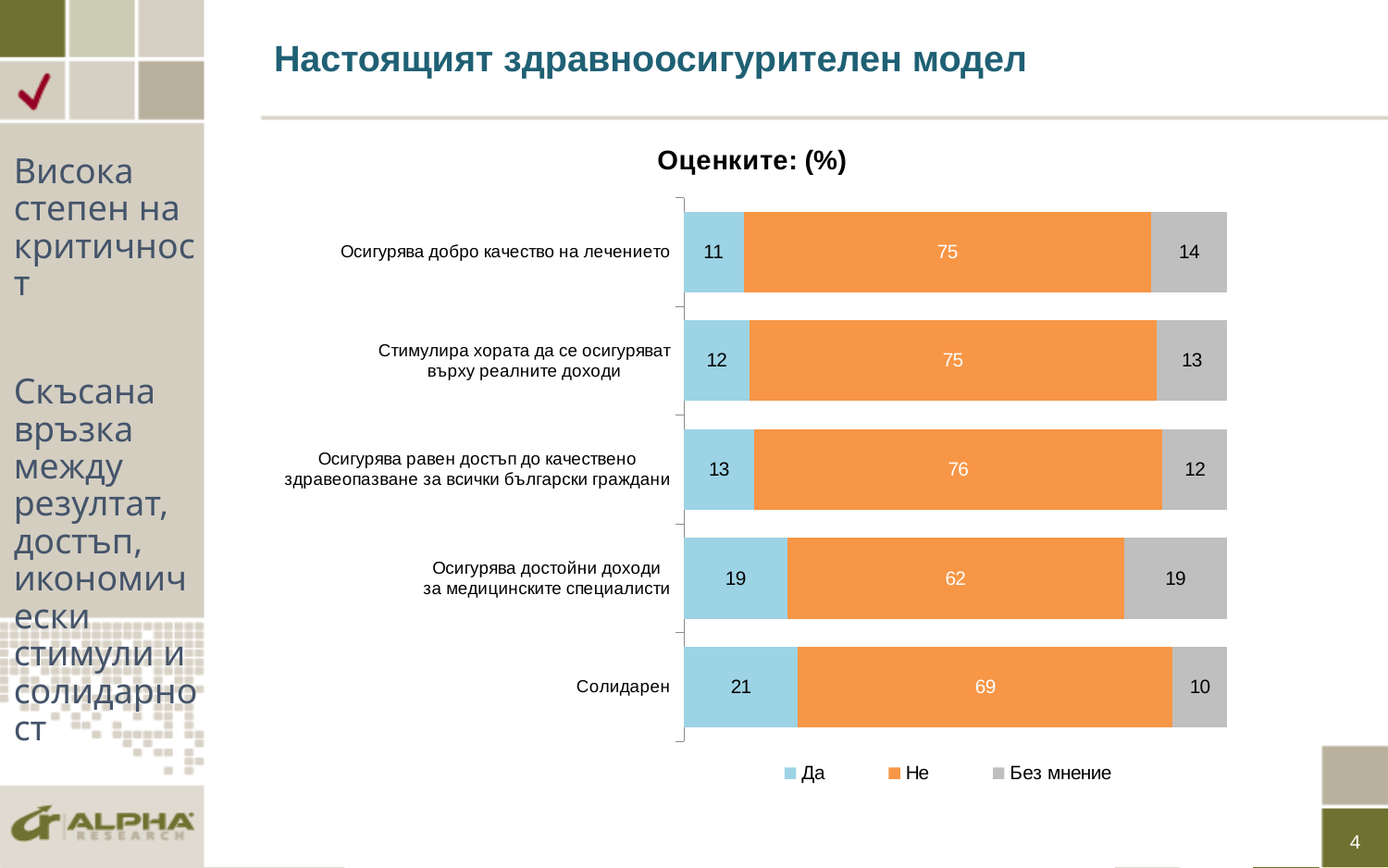
How many categories are plotted in the chart? 5 What type of chart is shown on the slide? Stacked bar chart What is the difference between the 'Не' values for 'Солидарен' and 'Осигурява достойни доходи за медицинските специалисти'? 7 What is the title of the chart? Оценките: (%) Which is larger: the 'Да' value for 'Солидарен' or the 'Да' value for 'Стимулира хората да се осигуряват върху реалните доходи'? Солидарен Which category has the highest 'Не' value? Осигурява равен достъп до качествено здравеопазване за всички български граждани What is the 'Да' value for 'Солидарен'? 21 What is the total of the stacked bar for 'Осигурява достойни доходи за медицинските специалисти'? 100 What is the 'Не' value for 'Осигурява достойни доходи за медицинските специалисти'? 62 Which category has the lowest 'Да' value? Осигурява добро качество на лечението What is the 'Без мнение' value for 'Осигурява добро качество на лечението'? 14 How many series does the legend list? 3